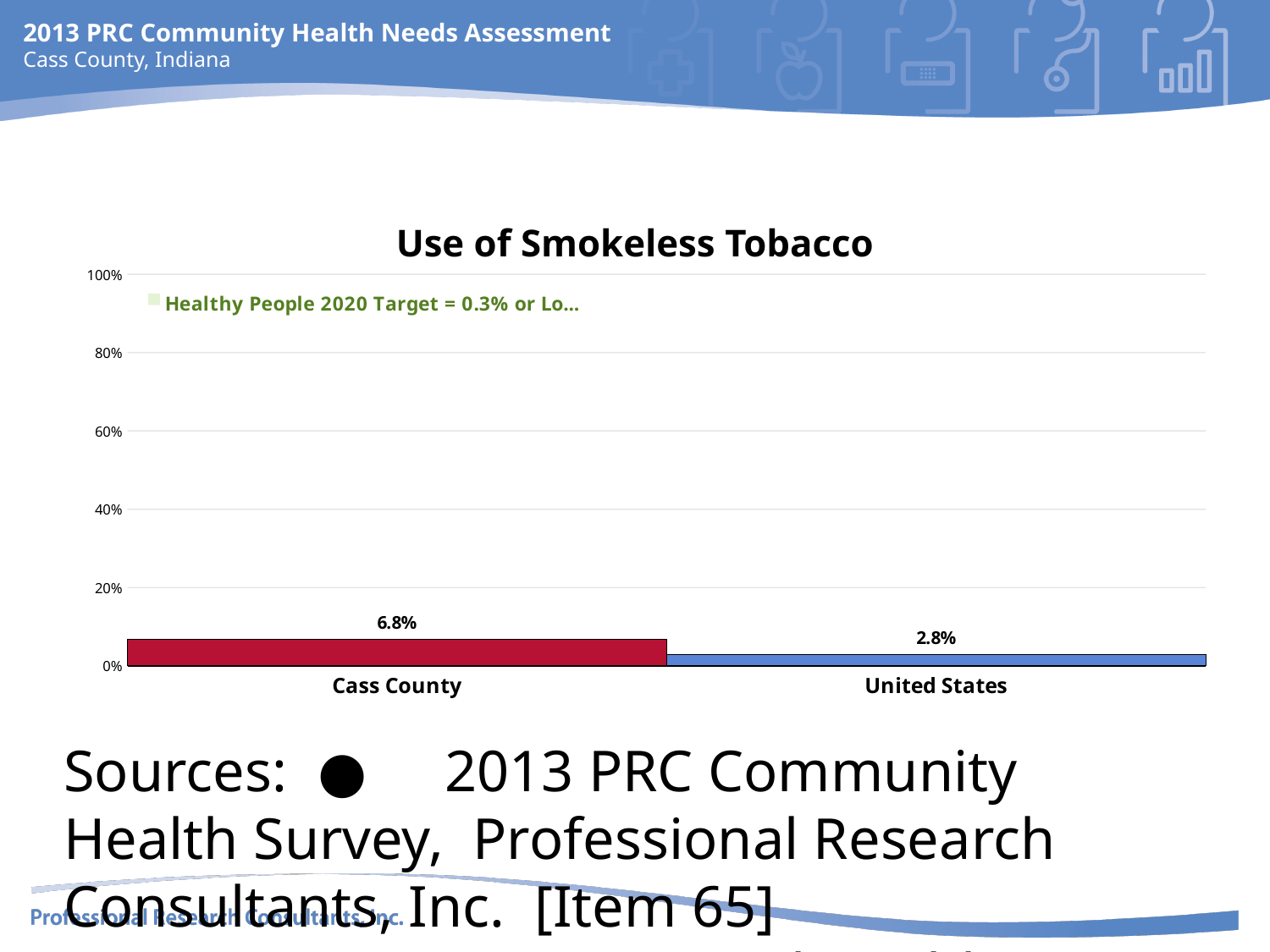
Which is larger in the Use of Smokeless Tobacco chart, the value for Cass County or the value for United States? Cass County What is the difference between the Cass County and United States values in the Use of Smokeless Tobacco chart? 4.0% Is the value for Cass County in the Use of Smokeless Tobacco chart greater or less than 20%? less Which category has the highest value in the Use of Smokeless Tobacco chart? Cass County What is the title of the chart on the slide? Use of Smokeless Tobacco What is the value for Cass County in the Use of Smokeless Tobacco chart? 6.8% What is the value for United States in the Use of Smokeless Tobacco chart? 2.8% How many categories are shown in the Use of Smokeless Tobacco chart? 2 What kind of chart is the Use of Smokeless Tobacco chart? bar chart Which category has the lowest value in the Use of Smokeless Tobacco chart? United States What is the highest value shown on the y axis of the Use of Smokeless Tobacco chart? 100%